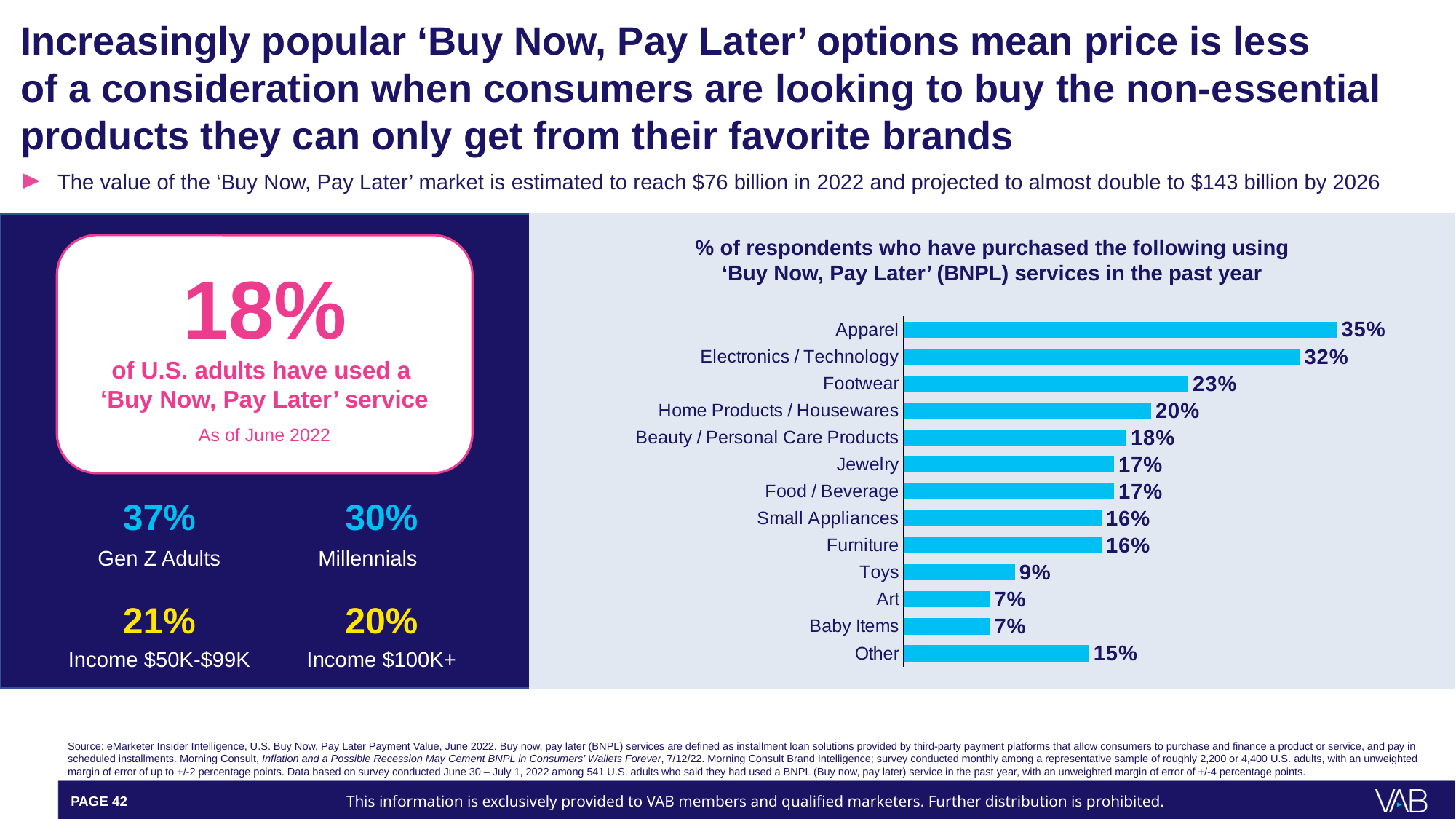
What percentage is shown for Toys? 9% Which is larger, the value for Footwear or the value for Furniture? Footwear What percentage of respondents purchased Apparel using BNPL services in the past year? 35% Which category has the highest percentage of respondents? Apparel What kind of chart is used to show the BNPL purchase categories? Bar chart How many categories are shown on the bar chart? 13 What is the value shown for Footwear? 23% What is the title of the chart? % of respondents who have purchased the following using 'Buy Now, Pay Later' (BNPL) services in the past year What is the difference between the values for Home Products / Housewares and Toys? 11% Which categories share the lowest value on the chart? Art and Baby Items What is the difference between the values for Apparel and Electronics / Technology? 3% What is the value shown for the Other category? 15%